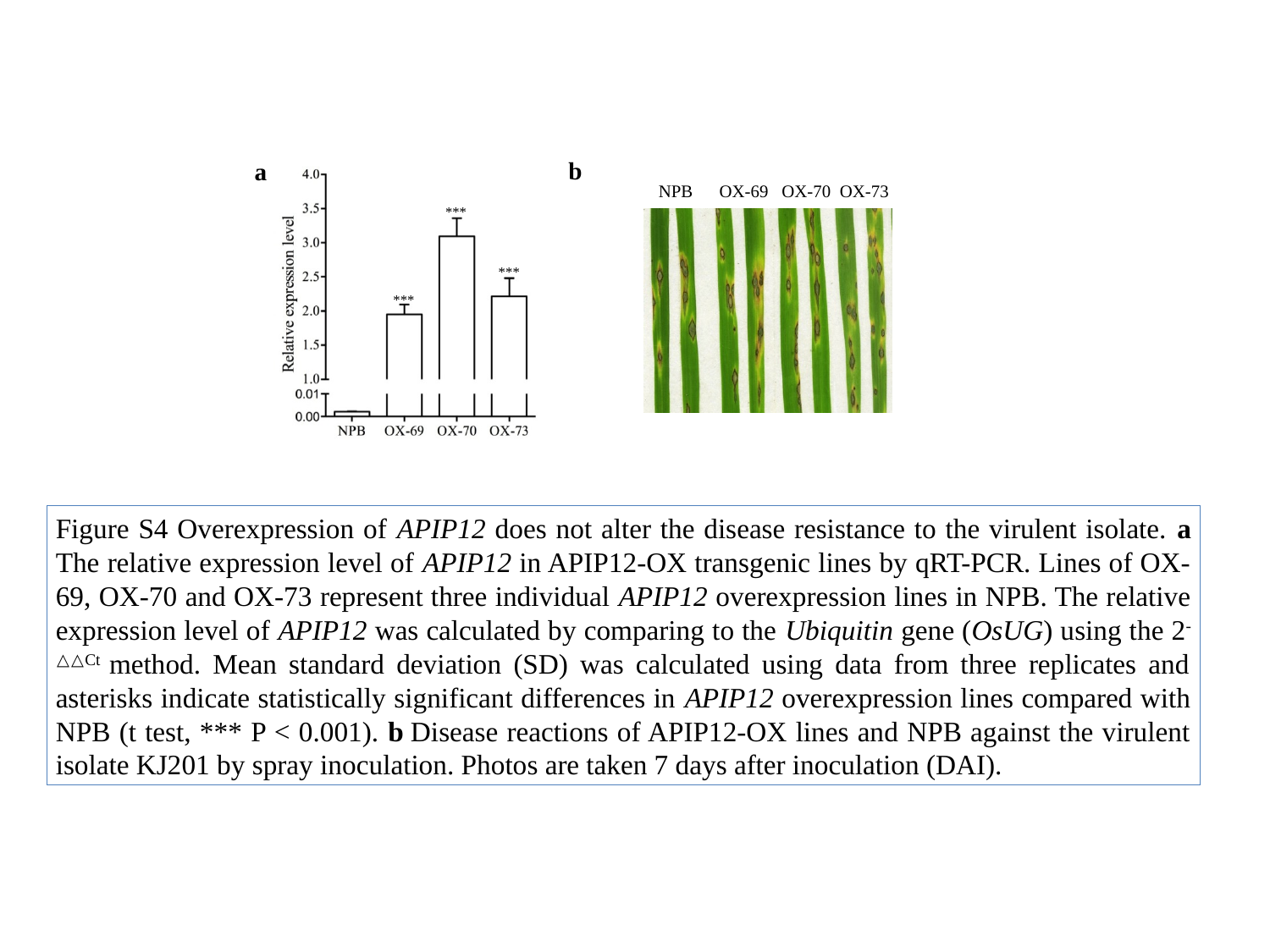
In the bar chart in panel a, which line has the highest relative expression level? OX-70 What is the y-axis label of the bar chart in panel a? Relative expression level In the bar chart in panel a, is the value for NPB greater or less than 1.0? less How many bars (categories) are plotted in the bar chart in panel a? 4 What kind of chart is panel a on the slide? bar chart In the bar chart in panel a, is the value for OX-70 greater or less than 2.5? greater In the bar chart in panel a, is the value for OX-69 greater or less than 1.5? greater In the bar chart in panel a, which has a higher relative expression level, OX-70 or OX-73? OX-70 In the bar chart in panel a, which category has the lowest relative expression level? NPB In the bar chart in panel a, which bars are marked with three asterisks (***)? OX-69, OX-70 and OX-73 In the bar chart in panel a, which has a higher relative expression level, OX-70 or OX-69? OX-70